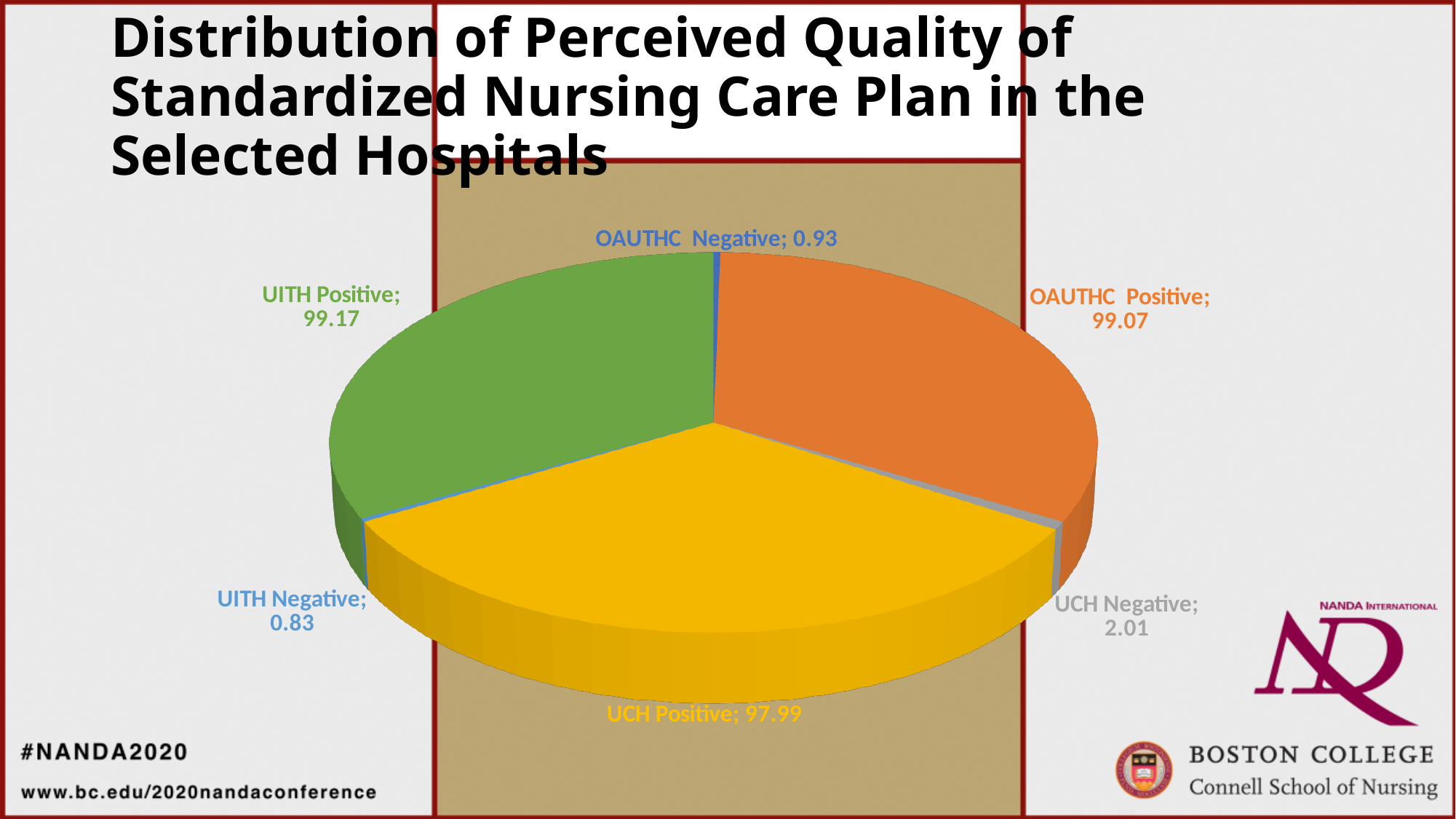
What kind of chart is shown on the slide? Pie chart How many slices does the pie chart have? 6 What value is shown for UCH Positive? 97.99 What is the difference between the UCH Negative and UITH Negative values? 1.18 What value is shown for UCH Negative? 2.01 Which slice has the largest value? UITH Positive Which slice has the smallest value? UITH Negative What value is shown for UITH Positive? 99.17 Which is larger, OAUTHC Positive or UCH Positive? OAUTHC Positive What value is shown for OAUTHC Negative? 0.93 What colour is the UCH Positive slice? Yellow What is the difference between the UCH Negative and OAUTHC Negative values? 1.08